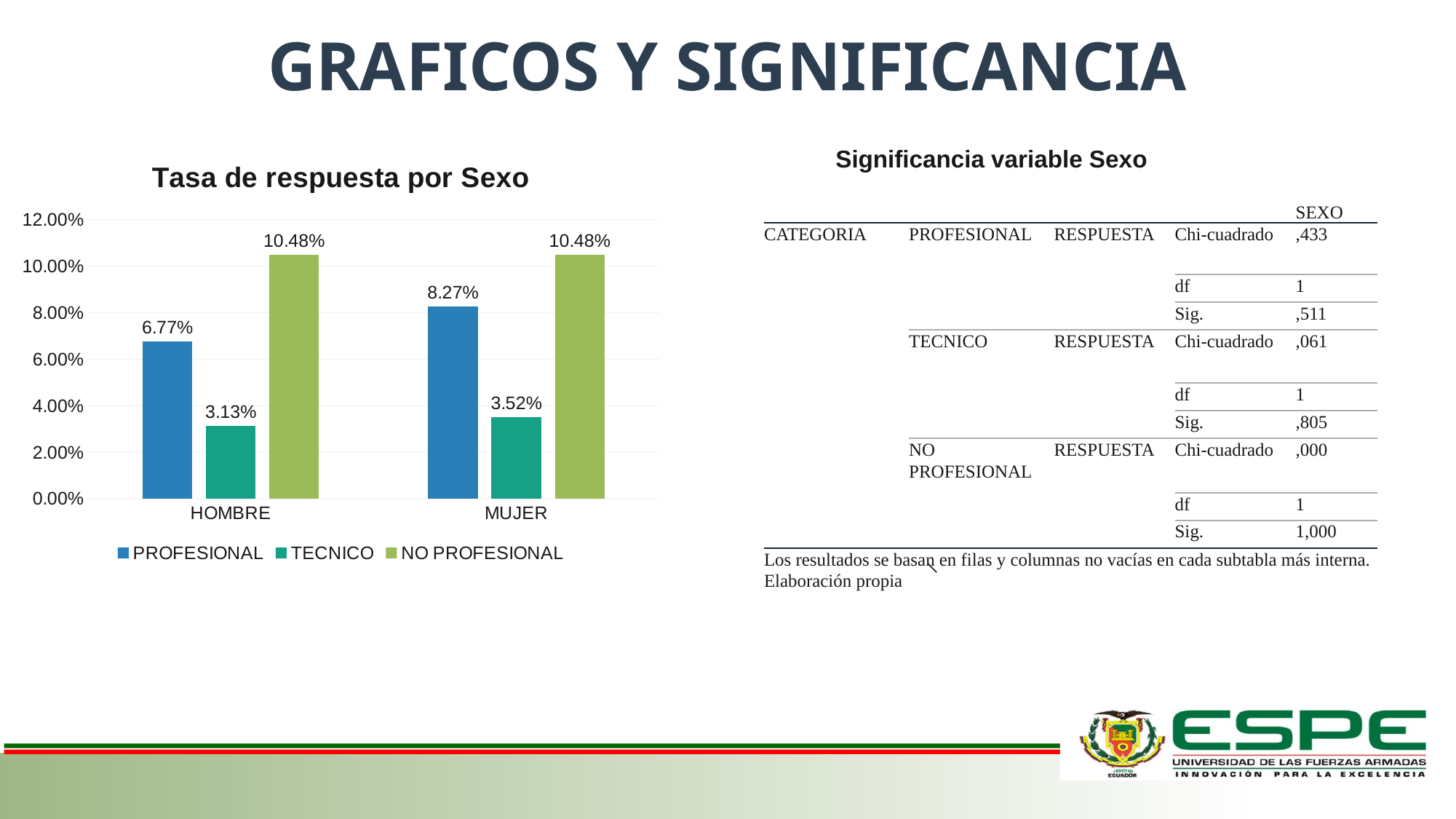
What kind of chart is shown? Bar chart How many series does the legend list? 3 What is the value for PROFESIONAL in the MUJER category? 8.27% What is the value for TECNICO in the MUJER category? 3.52% Which is larger, the TECNICO value for HOMBRE or for MUJER? MUJER What is the value for NO PROFESIONAL in the HOMBRE category? 10.48% Which series has the lowest value in the HOMBRE category? TECNICO Which series has the highest value in the MUJER category? NO PROFESIONAL What is the difference between the PROFESIONAL values for MUJER and HOMBRE? 1.50% What is the title of the chart? Tasa de respuesta por Sexo What is the value for PROFESIONAL in the HOMBRE category? 6.77% How many categories are shown on the x axis? 2